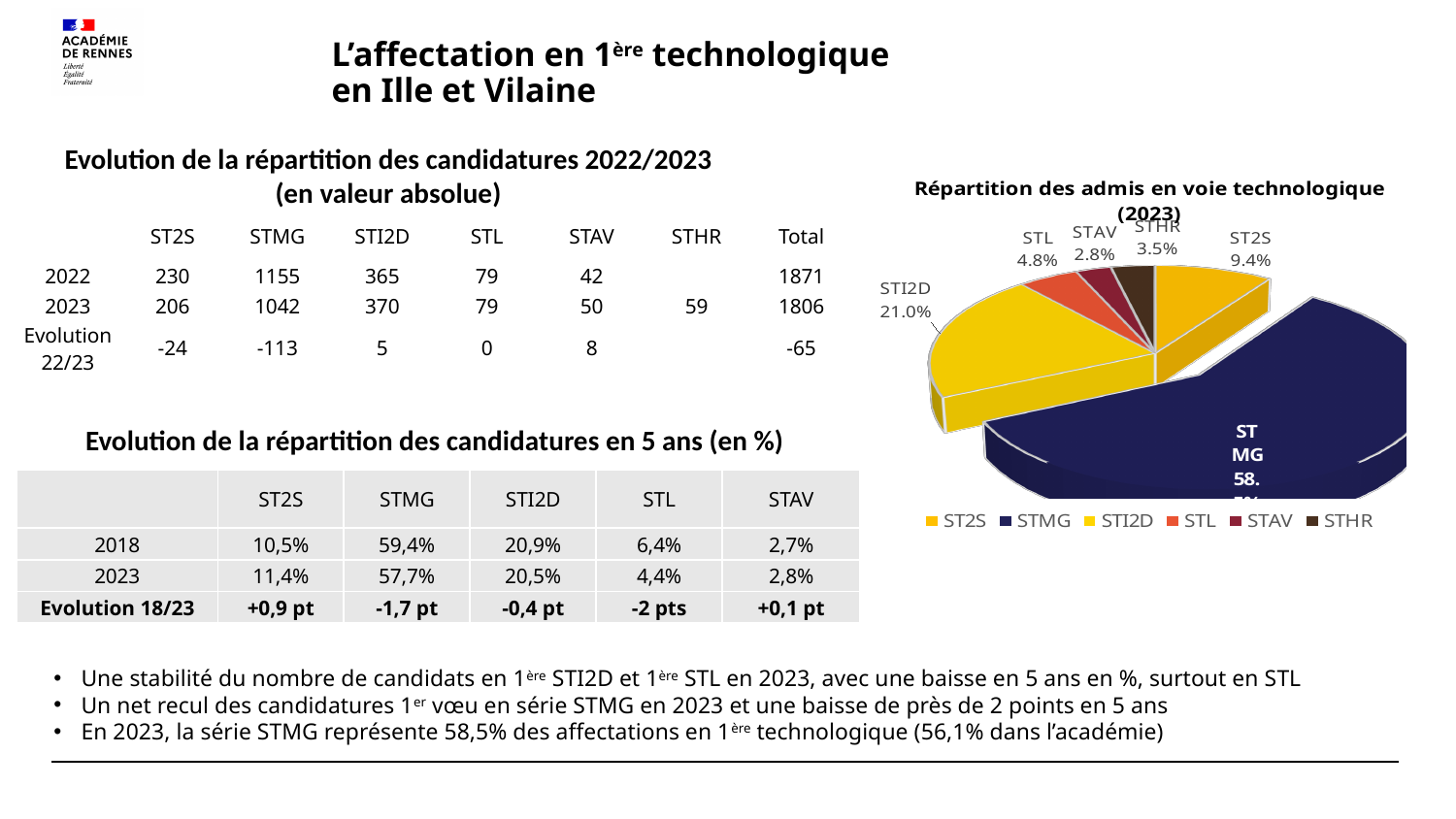
In the pie chart, what is the difference between the STI2D share and the ST2S share? 11.6% What is the title of the pie chart? Répartition des admis en voie technologique (2023) In the pie chart, what share is shown for STAV? 2.8% In the pie chart, what share is shown for ST2S? 9.4% How many series does the legend of the pie chart list? 6 Which series has the smallest slice in the pie chart? STAV In the pie chart, what share is shown for STL? 4.8% What kind of chart is 'Répartition des admis en voie technologique (2023)'? pie chart Which series has the largest slice in the pie chart? STMG In the pie chart, what share is shown for STHR? 3.5% In the pie chart, which is larger, the share for STL or the share for STHR? STL In the pie chart, what share is shown for STI2D? 21.0%